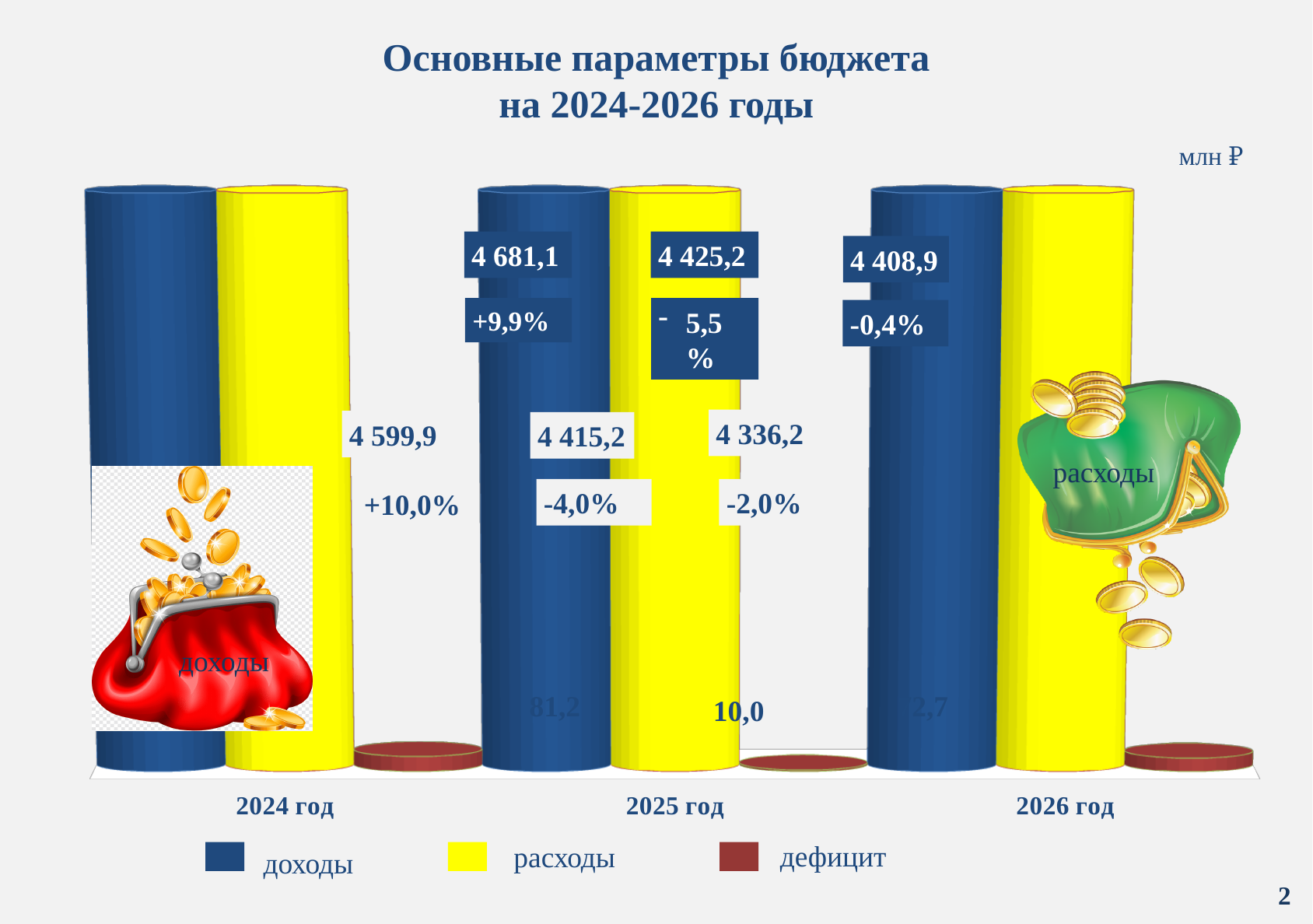
Which value is printed together with the change -2,0%? 4 336,2 Which value is printed together with the change -4,0%? 4 415,2 What unit is indicated for the chart values? млн ₽ What is the title of the chart? Основные параметры бюджета на 2024-2026 годы How many year categories are shown on the x axis? 3 Which value is printed together with the change -0,4%? 4 408,9 What percentage change is printed next to the value 4 681,1? +9,9% Which series has the smallest bars in every year? дефицит What percentage change is printed next to the value 4 599,9? +10,0% What kind of chart is shown on the slide? bar chart How many series does the legend list? 3 Which series is shown in yellow according to the legend? расходы